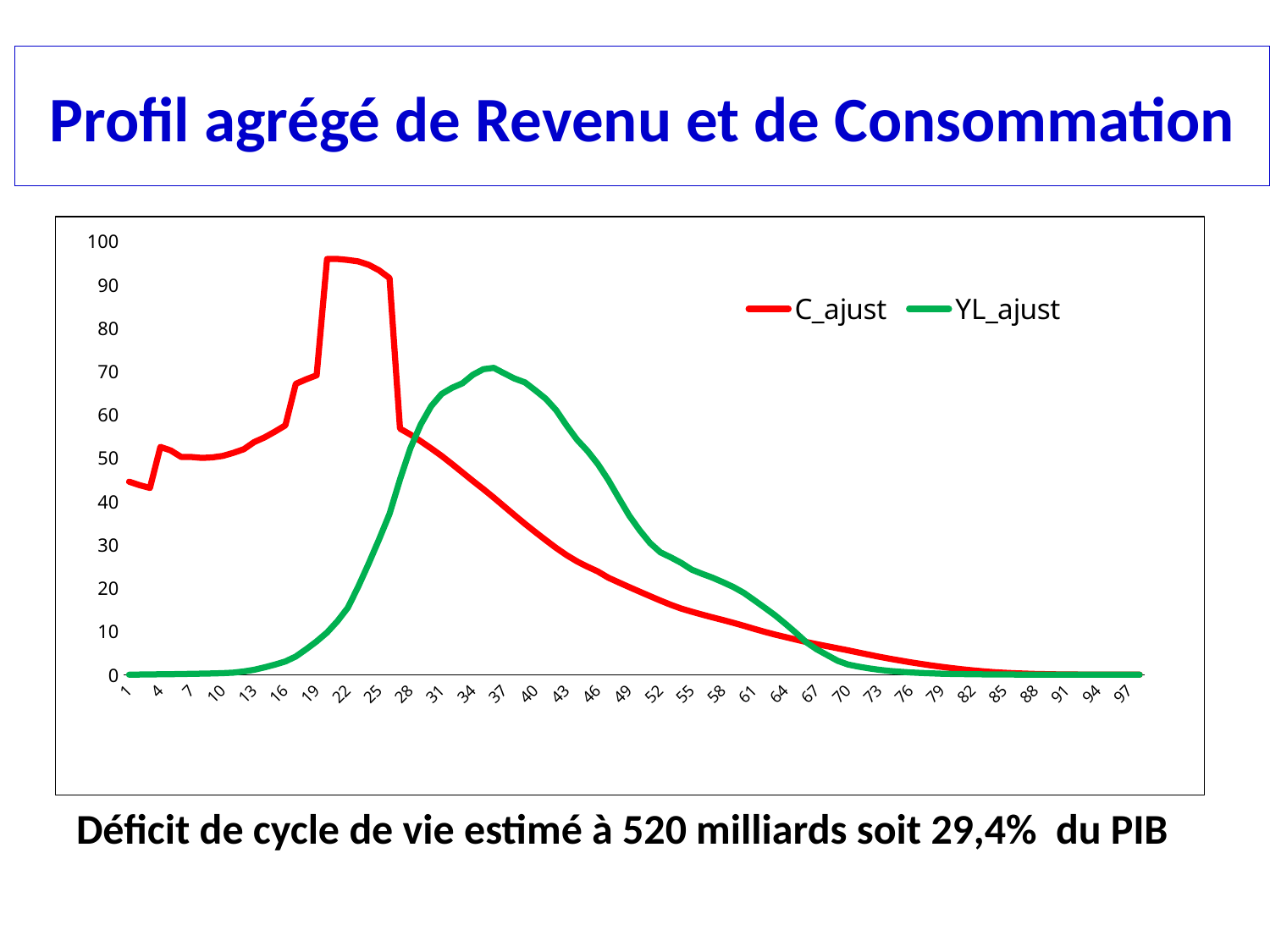
How many series does the legend list? 2 What is the highest value shown on the vertical axis? 100 Which series is drawn in green? YL_ajust Is the value of YL_ajust at 10 greater or less than 10? less What kind of chart is shown on the slide? line chart Is the value of C_ajust at 70 greater or less than 10? less At 22 on the x axis, which series has the higher value, C_ajust or YL_ajust? C_ajust Is the value of C_ajust at 22 greater or less than 90? greater Which series reaches the highest peak value on the chart? C_ajust At 37 on the x axis, which series has the higher value, C_ajust or YL_ajust? YL_ajust